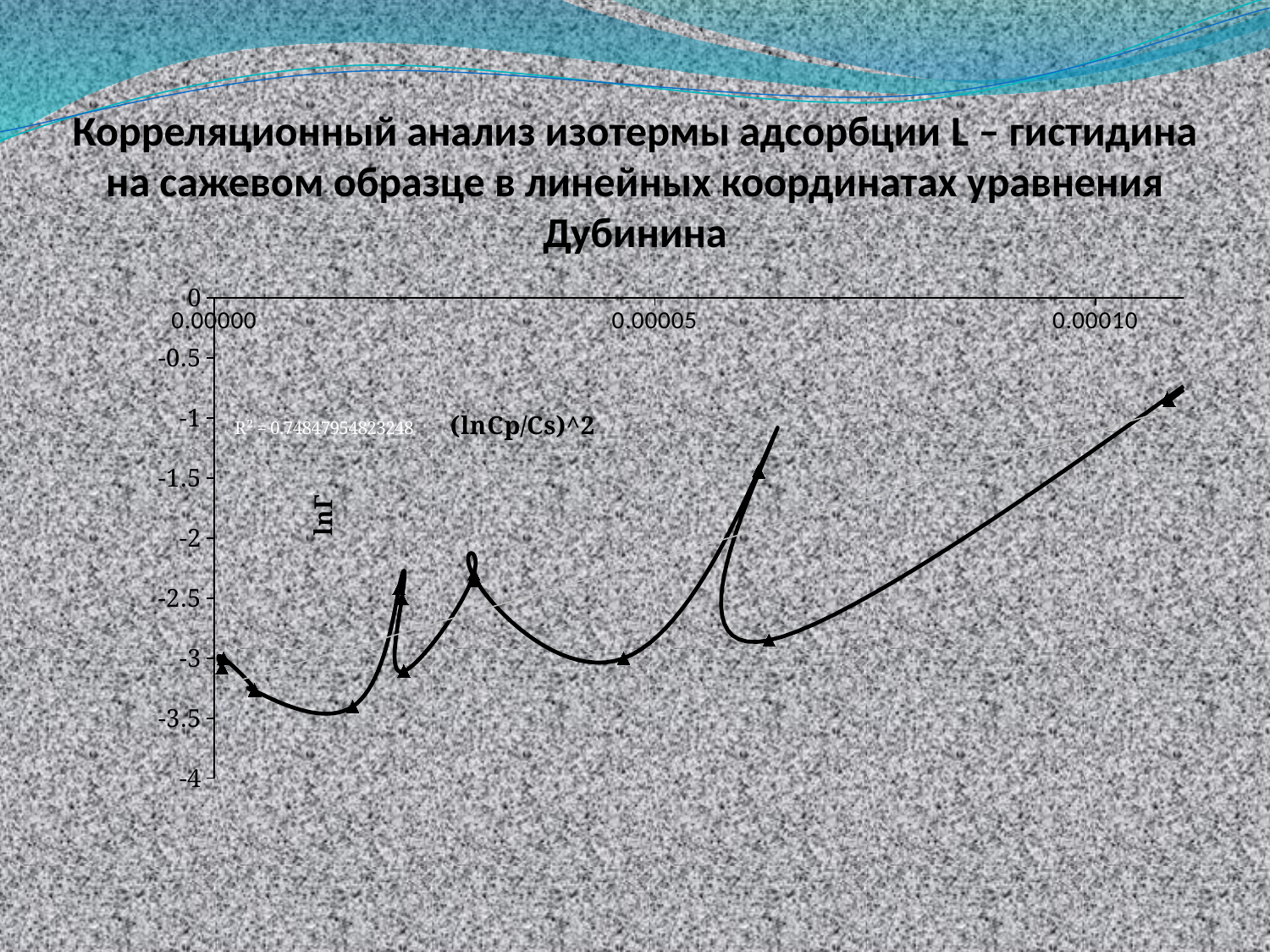
What is the lowest value labelled on the vertical axis? -4 Is the value of lnГ for the point at x = 0.00000 greater or less than -2.5? less What R² value is printed on the chart? R² = 0.74847954823248 Is the value of lnГ for the lowest point of the curve (near x = 0.00001) greater or less than -3? less What is the title of the chart on the slide? Корреляционный анализ изотермы адсорбции L – гистидина на сажевом образце в линейных координатах уравнения Дубинина Overall, does lnГ rise or fall as (lnCp/Cs)^2 increases from 0.00000 to 0.00010? rise Which point has the highest lnГ value: the point near x = 0.00006 or the rightmost point near x = 0.00010? the rightmost point near x = 0.00010 Is the value of lnГ for the rightmost point (near x = 0.00010) greater or less than -1? greater What kind of chart is shown on the slide? line chart